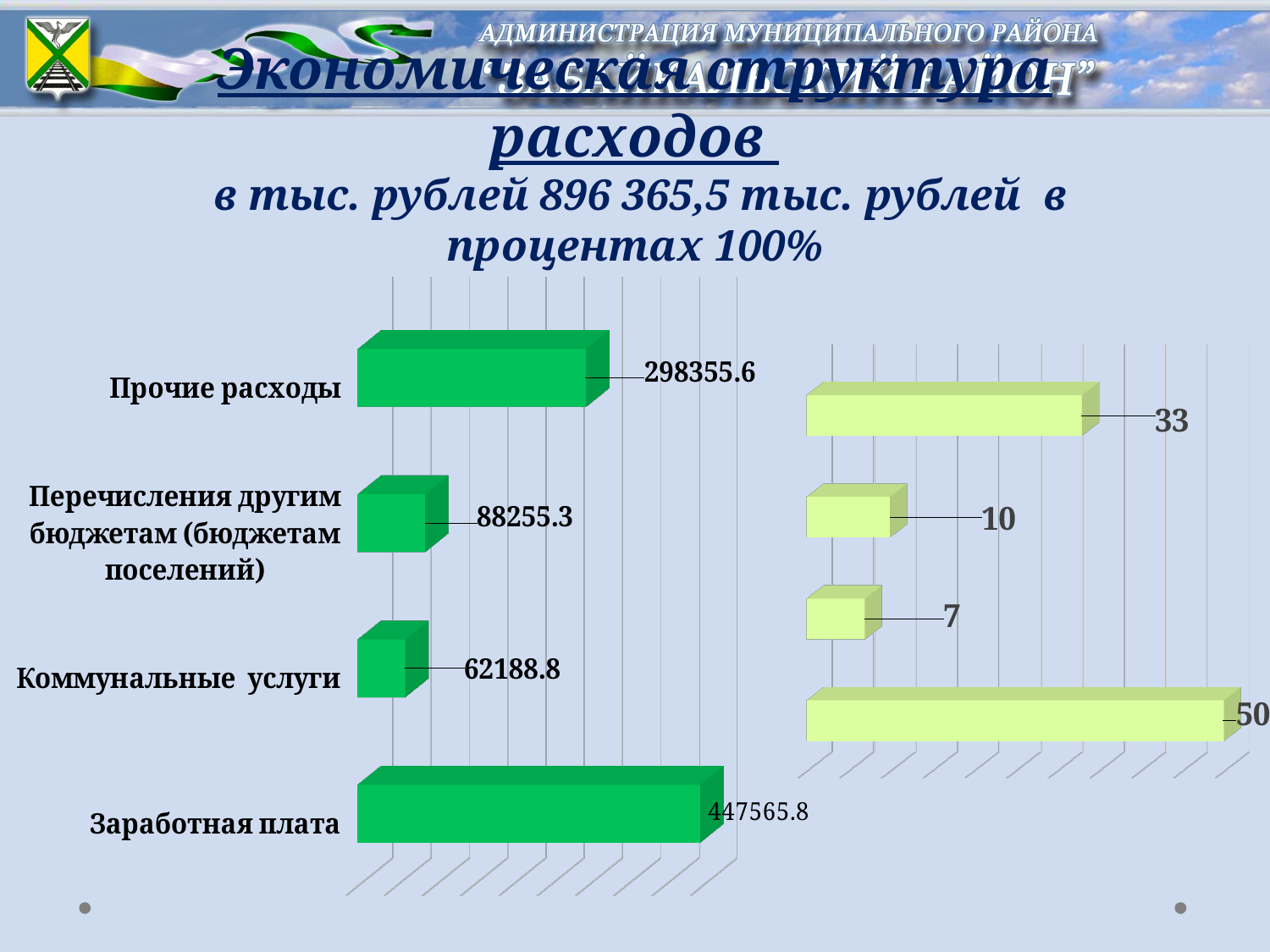
In the left chart (values in thousand rubles), what is the value for Коммунальные услуги? 62188.8 In the left chart (values in thousand rubles), what is the value for Прочие расходы? 298355.6 In the right chart (percentages), what is the value of the bottom bar? 50 What type of chart is the left chart (values in thousand rubles)? Bar chart In the left chart (values in thousand rubles), what is the difference between Заработная плата and Прочие расходы? 149210.2 In the left chart (values in thousand rubles), which is larger: Перечисления другим бюджетам (бюджетам поселений) or Коммунальные услуги? Перечисления другим бюджетам (бюджетам поселений) In the left chart (values in thousand rubles), what is the value for Заработная плата? 447565.8 In the left chart (values in thousand rubles), which category has the highest value? Заработная плата In the left chart (values in thousand rubles), which category has the lowest value? Коммунальные услуги In the left chart (values in thousand rubles), what is the value for Перечисления другим бюджетам (бюджетам поселений)? 88255.3 How many categories are shown in the left chart (values in thousand rubles)? 4 In the right chart (percentages), what is the value of the top bar? 33